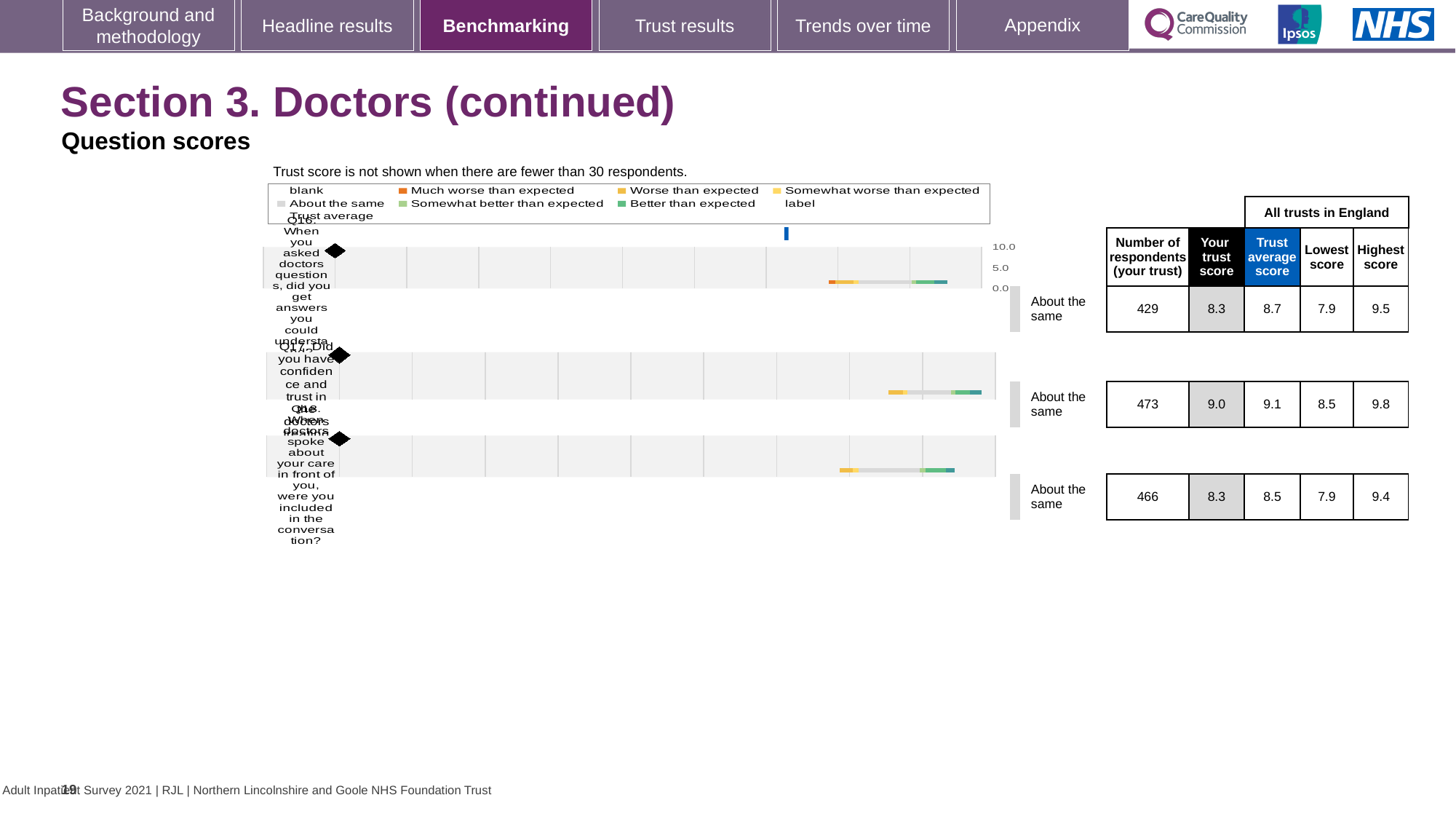
How many questions are plotted on this slide? 3 How many respondents from your trust answered Q17? 473 What is the maximum value shown on the chart's axis? 10.0 Which question has the lowest 'Lowest score' across all trusts in England? Q16 and Q18 (both 7.9) What is the 'Your trust score' for Q17 (Did you have confidence and trust in the doctors treating you)? 9.0 Which of the three questions shown has the highest 'Your trust score'? Q17 What benchmark category is shown for Q18? About the same What is the difference between the trust average score and your trust score for Q16? 0.4 Is the highest score for Q17 larger than the highest score for Q18? Yes, 9.8 vs 9.4 What is the trust average score for Q18 (When doctors spoke about your care in front of you, were you included in the conversation)? 8.5 What is the 'Your trust score' for Q16 (When you asked doctors questions, did you get answers you could understand)? 8.3 What is the highest score across all trusts in England for Q16? 9.5